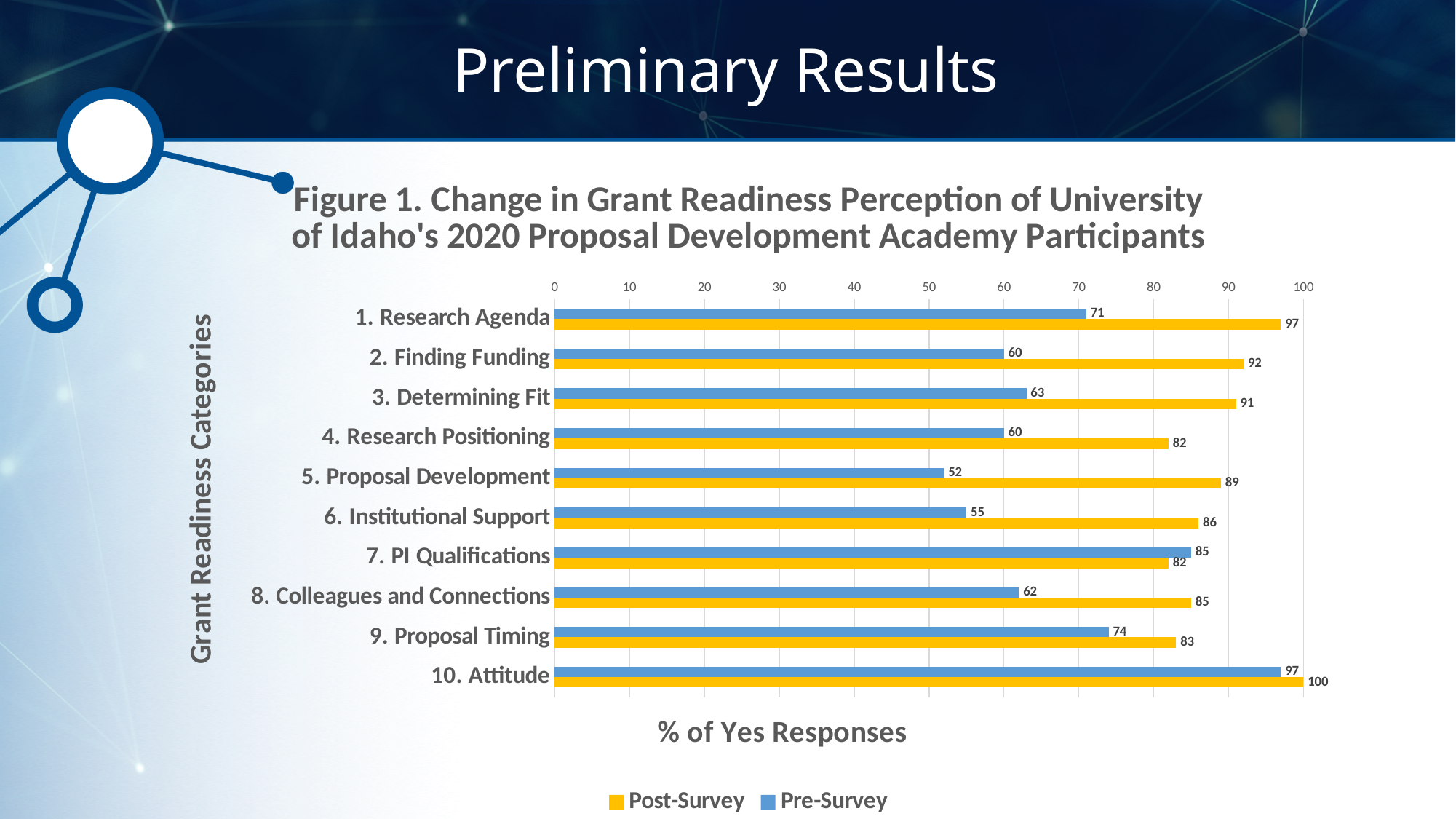
What is the Pre-Survey value for 9. Proposal Timing? 74 How many series does the legend list? 2 What is the difference between the Post-Survey and Pre-Survey values for 2. Finding Funding? 32 Which colour represents the Post-Survey series? Yellow How many grant readiness categories are shown on the chart? 10 What kind of chart is shown on the slide? Bar chart Which category has the highest Post-Survey value? 10. Attitude What is the Post-Survey value for 5. Proposal Development? 89 Which is larger for 7. PI Qualifications, the Pre-Survey value or the Post-Survey value? Pre-Survey What is the label of the horizontal axis? % of Yes Responses What is the Pre-Survey value for 1. Research Agenda? 71 Which category has the lowest Pre-Survey value? 5. Proposal Development